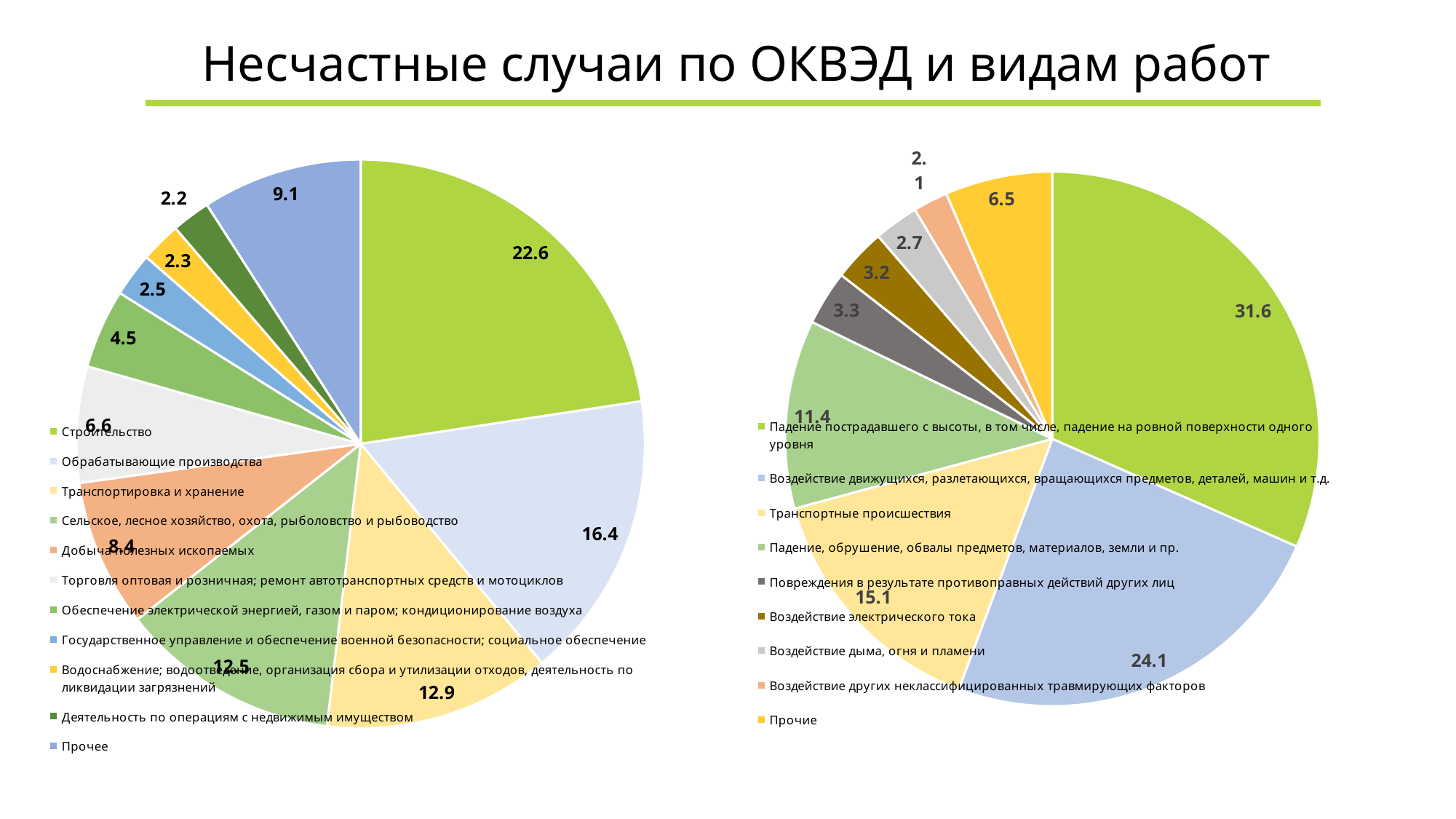
In the right pie chart (by вид работ), which is larger: Воздействие движущихся, разлетающихся, вращающихся предметов, деталей, машин и т.д. or Падение, обрушение, обвалы предметов, материалов, земли и пр.? Воздействие движущихся, разлетающихся, вращающихся предметов, деталей, машин и т.д. In the right pie chart (by вид работ), what is the value for Транспортные происшествия? 15.1 In the left pie chart (by ОКВЭД), which category has the smallest share? Деятельность по операциям с недвижимым имуществом What type of chart is used on the left side of the slide? Pie chart In the left pie chart (by ОКВЭД), which category has the largest share? Строительство What is the title of the slide? Несчастные случаи по ОКВЭД и видам работ In the right pie chart (by вид работ), what is the difference between Падение пострадавшего с высоты and Воздействие движущихся предметов? 7.5 In the left pie chart (by ОКВЭД), what is the difference between Строительство and Обрабатывающие производства? 6.2 In the left pie chart (by ОКВЭД), what is the value for Обрабатывающие производства? 16.4 In the left pie chart (by ОКВЭД), what is the value for Строительство? 22.6 In the right pie chart (by вид работ), which category has the largest share? Падение пострадавшего с высоты, в том числе, падение на ровной поверхности одного уровня How many categories does the legend of the left pie chart (by ОКВЭД) list? 11